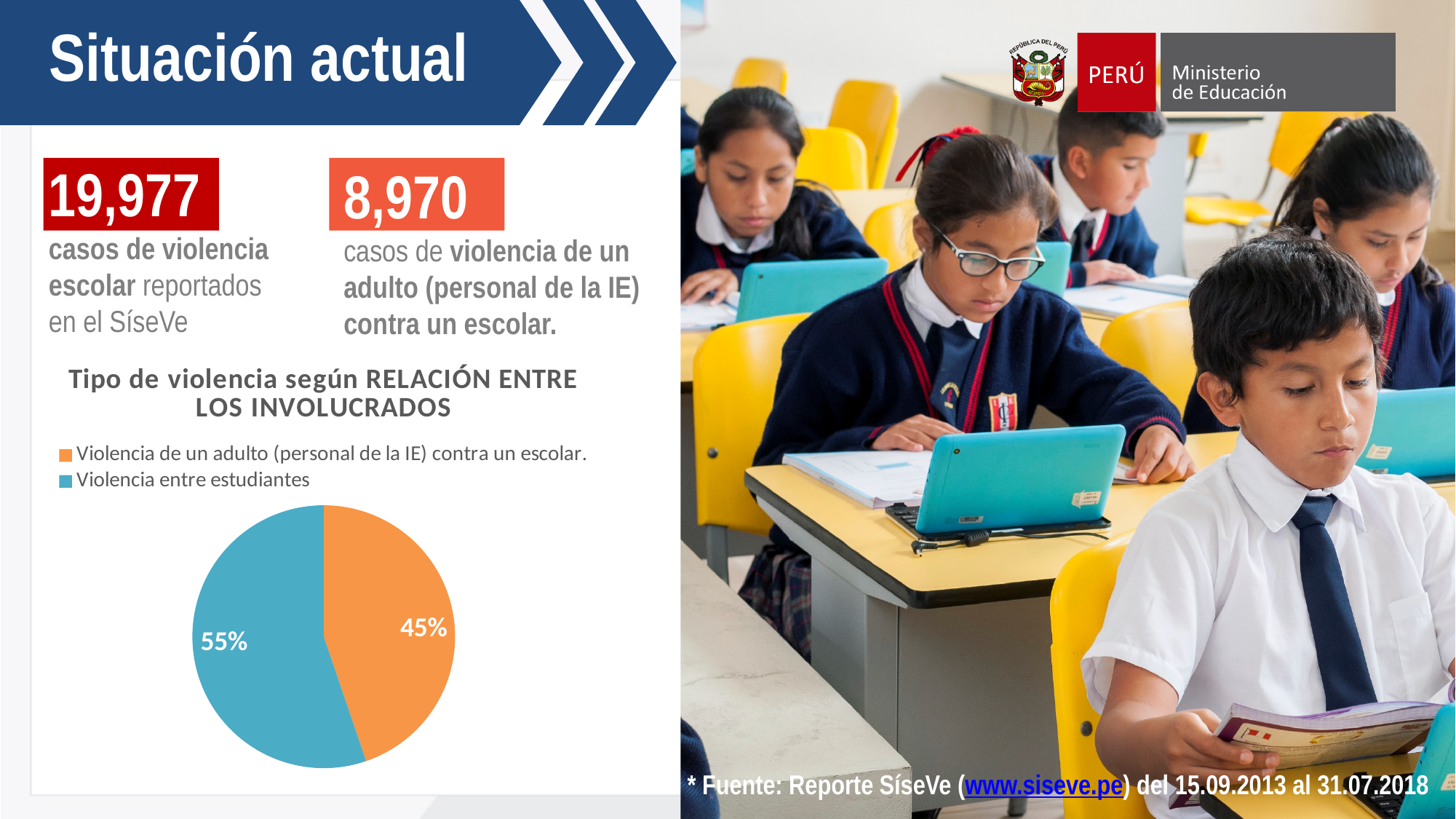
How many slices does the pie chart have? 2 What share of the pie is 'Violencia de un adulto (personal de la IE) contra un escolar.'? 45% Which category has the smallest slice of the pie? Violencia de un adulto (personal de la IE) contra un escolar. What colour is the slice for 'Violencia entre estudiantes'? blue What is the title of the chart? Tipo de violencia según RELACIÓN ENTRE LOS INVOLUCRADOS What kind of chart is shown on the slide? pie chart Which is larger: the share for 'Violencia entre estudiantes' or the share for 'Violencia de un adulto (personal de la IE) contra un escolar.'? Violencia entre estudiantes Which category has the largest slice of the pie? Violencia entre estudiantes What share of the pie is 'Violencia entre estudiantes'? 55% What is the difference in percentage points between the 'Violencia entre estudiantes' slice and the 'Violencia de un adulto (personal de la IE) contra un escolar.' slice? 10 percentage points How many entries does the chart legend list? 2